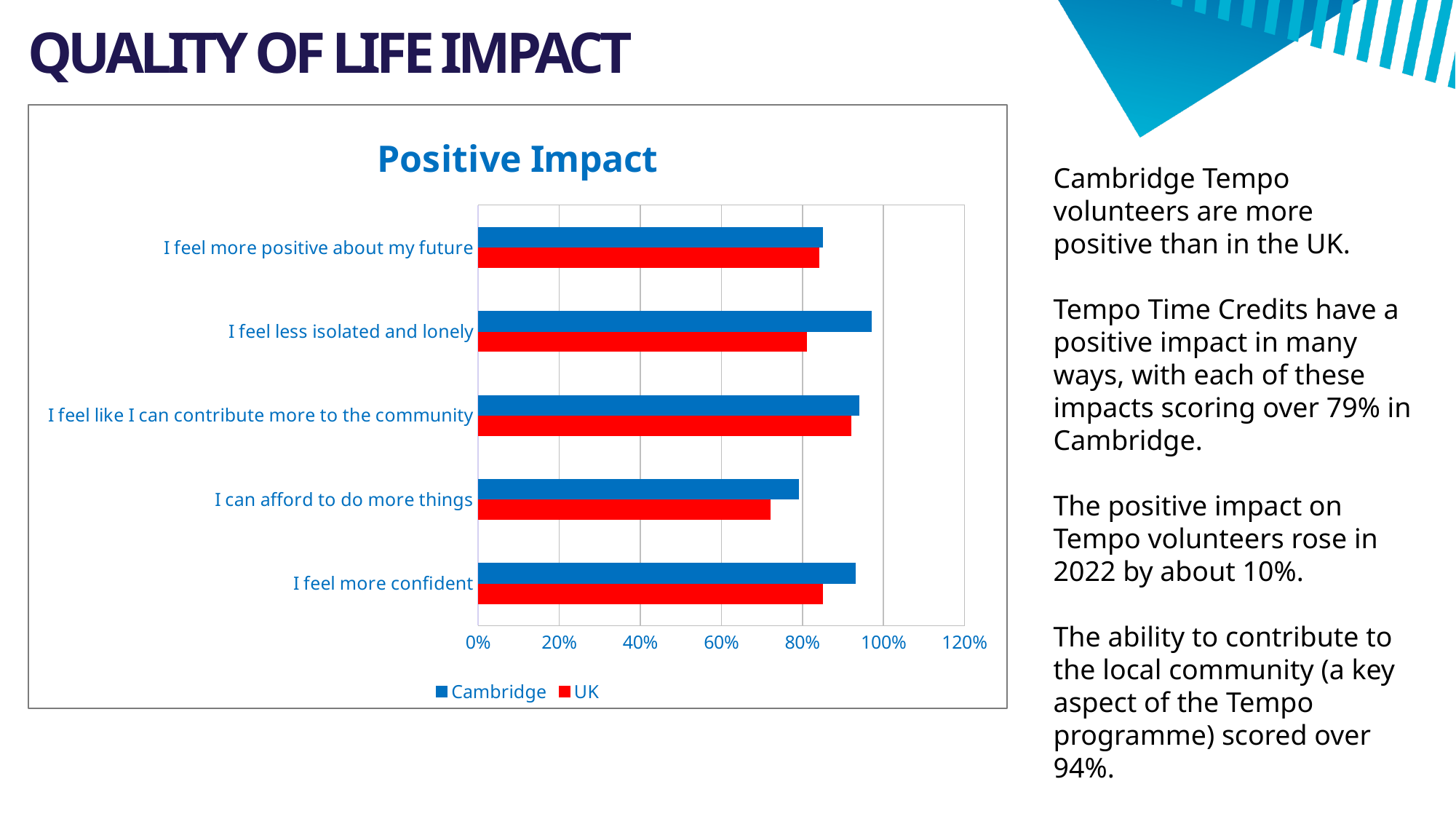
For 'I feel more confident', which is larger, the Cambridge value or the UK value? Cambridge How many categories are plotted on the chart? 5 How many series does the legend list? 2 Which colour represents the UK series in the chart? red What is the title of the chart? Positive Impact Which category has the lowest Cambridge value? I can afford to do more things What kind of chart is shown on the slide? bar chart Which category has the highest UK value? I feel like I can contribute more to the community Is the Cambridge value for 'I feel less isolated and lonely' greater or less than 80%? greater Which category has the lowest UK value? I can afford to do more things For 'I feel less isolated and lonely', which is larger, the Cambridge value or the UK value? Cambridge Is the UK value for 'I can afford to do more things' greater or less than 80%? less